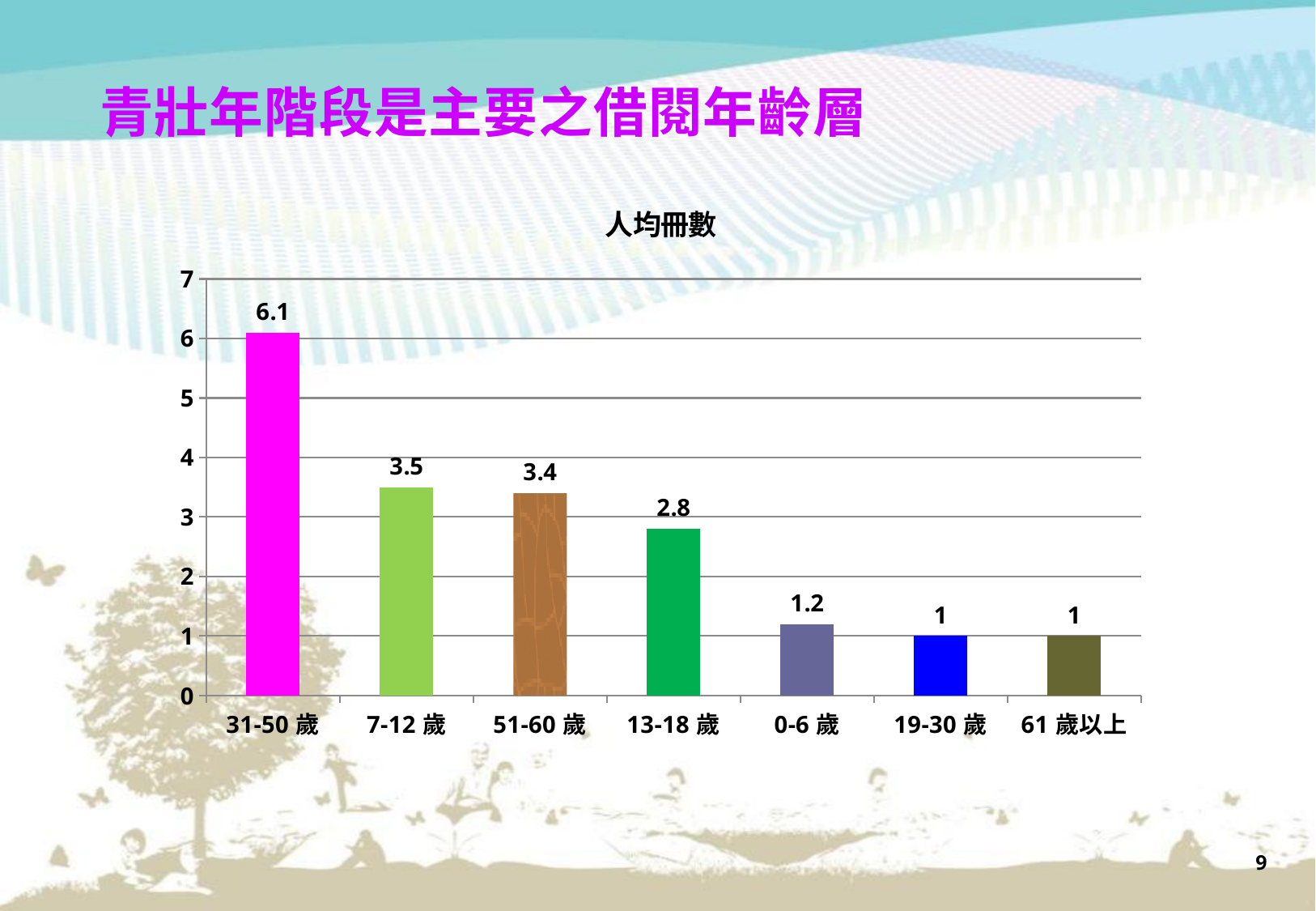
Do the values rise or fall from left to right along the x axis? fall What is the difference between the values for 7-12 歲 and 51-60 歲? 0.1 Which is larger, the value for 13-18 歲 or the value for 0-6 歲? 13-18 歲 What is the value for 13-18 歲? 2.8 What is the difference between the values for 31-50 歲 and 7-12 歲? 2.6 What is the title of the chart? 人均冊數 What is the value for 31-50 歲? 6.1 What is the value for 0-6 歲? 1.2 Is the value for 51-60 歲 greater or less than 3? greater Which age group has the highest value? 31-50 歲 What kind of chart is shown on the slide? bar chart How many age groups are shown on the chart? 7